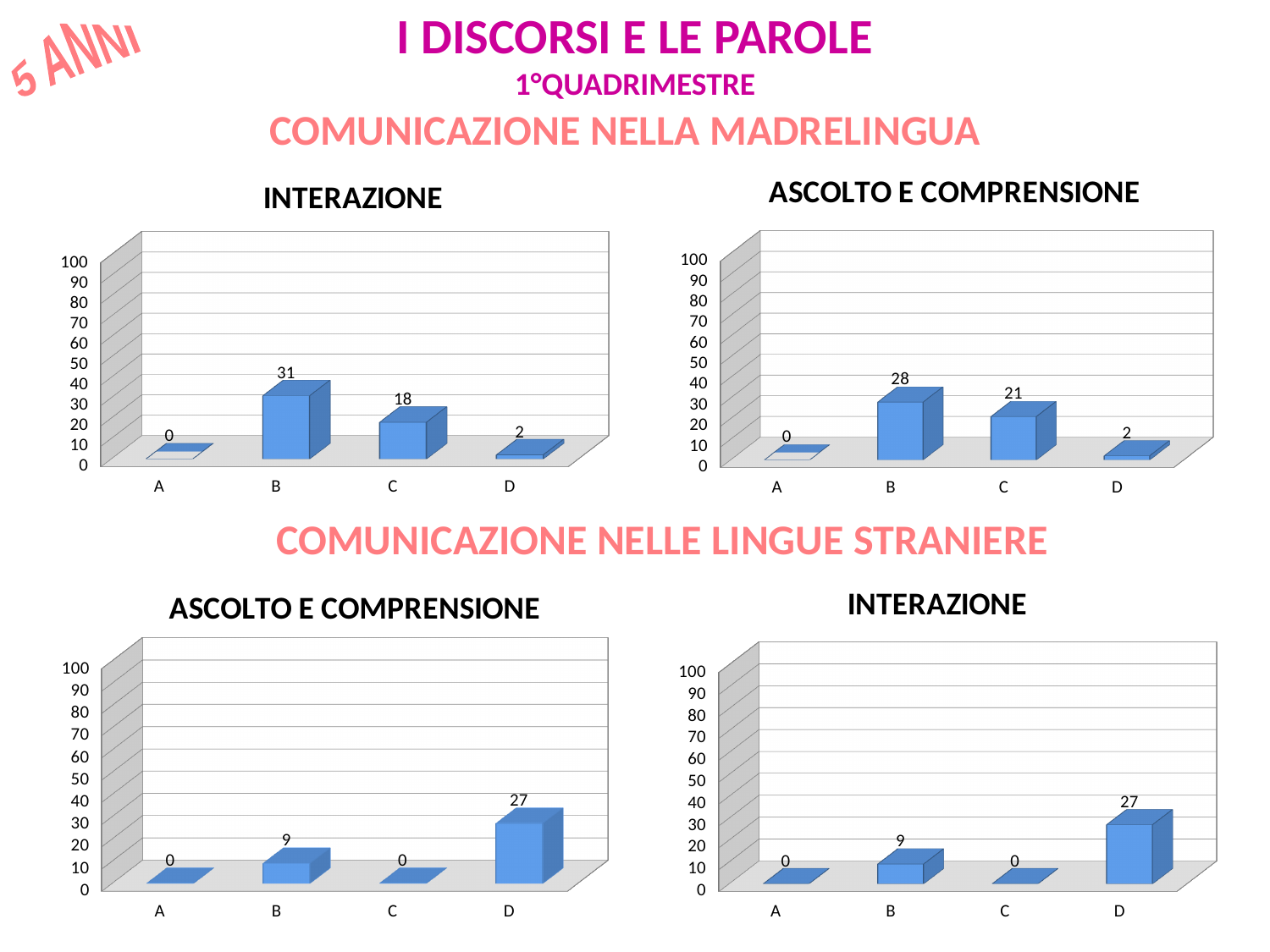
In the top-left chart (INTERAZIONE under COMUNICAZIONE NELLA MADRELINGUA), what is the value for category B? 31 In the top-right chart (ASCOLTO E COMPRENSIONE under COMUNICAZIONE NELLA MADRELINGUA), which category has the lowest value? A What kind of chart is the bottom-right chart (INTERAZIONE under COMUNICAZIONE NELLE LINGUE STRANIERE)? Bar chart In the top-left chart (INTERAZIONE under COMUNICAZIONE NELLA MADRELINGUA), what is the difference between the values for B and C? 13 In the top-right chart (ASCOLTO E COMPRENSIONE under COMUNICAZIONE NELLA MADRELINGUA), what is the value for category C? 21 In the top-left chart (INTERAZIONE under COMUNICAZIONE NELLA MADRELINGUA), which category has the highest value? B In the bottom-right chart (INTERAZIONE under COMUNICAZIONE NELLE LINGUE STRANIERE), what is the value for category B? 9 In the bottom-right chart (INTERAZIONE under COMUNICAZIONE NELLE LINGUE STRANIERE), what is the difference between the values for D and B? 18 In the bottom-left chart (ASCOLTO E COMPRENSIONE under COMUNICAZIONE NELLE LINGUE STRANIERE), what is the value for category D? 27 In the bottom-left chart (ASCOLTO E COMPRENSIONE under COMUNICAZIONE NELLE LINGUE STRANIERE), which category has the highest value? D In the top-right chart (ASCOLTO E COMPRENSIONE under COMUNICAZIONE NELLA MADRELINGUA), which is larger, the value for B or the value for C? B How many categories are shown on the x axis of the top-left chart (INTERAZIONE under COMUNICAZIONE NELLA MADRELINGUA)? 4